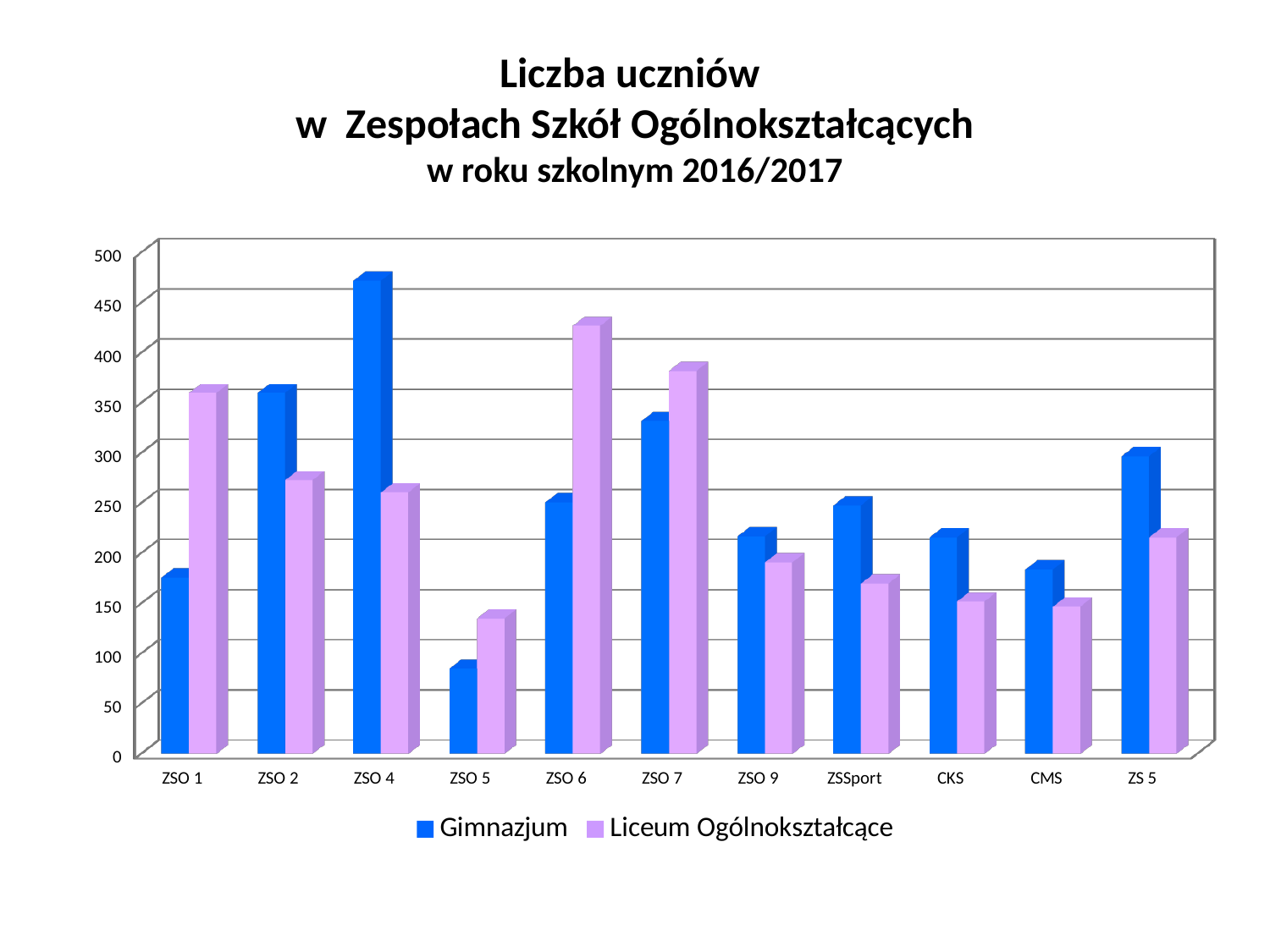
What kind of chart is shown on the slide? bar chart For ZSSport, which is larger: Gimnazjum or Liceum Ogólnokształcące? Gimnazjum How many school categories are shown on the x axis? 11 Which school has the highest Gimnazjum value? ZSO 4 How many series does the legend list? 2 Which school has the lowest Gimnazjum value? ZSO 5 Which school has the highest Liceum Ogólnokształcące value? ZSO 6 Is the Gimnazjum value for ZSO 5 greater or less than 100? less Is the Gimnazjum value for ZSO 4 greater or less than 400? greater For ZSO 1, which is larger: Gimnazjum or Liceum Ogólnokształcące? Liceum Ogólnokształcące Which colour represents the Gimnazjum series? blue Is the Liceum Ogólnokształcące value for ZSO 6 greater or less than 400? greater